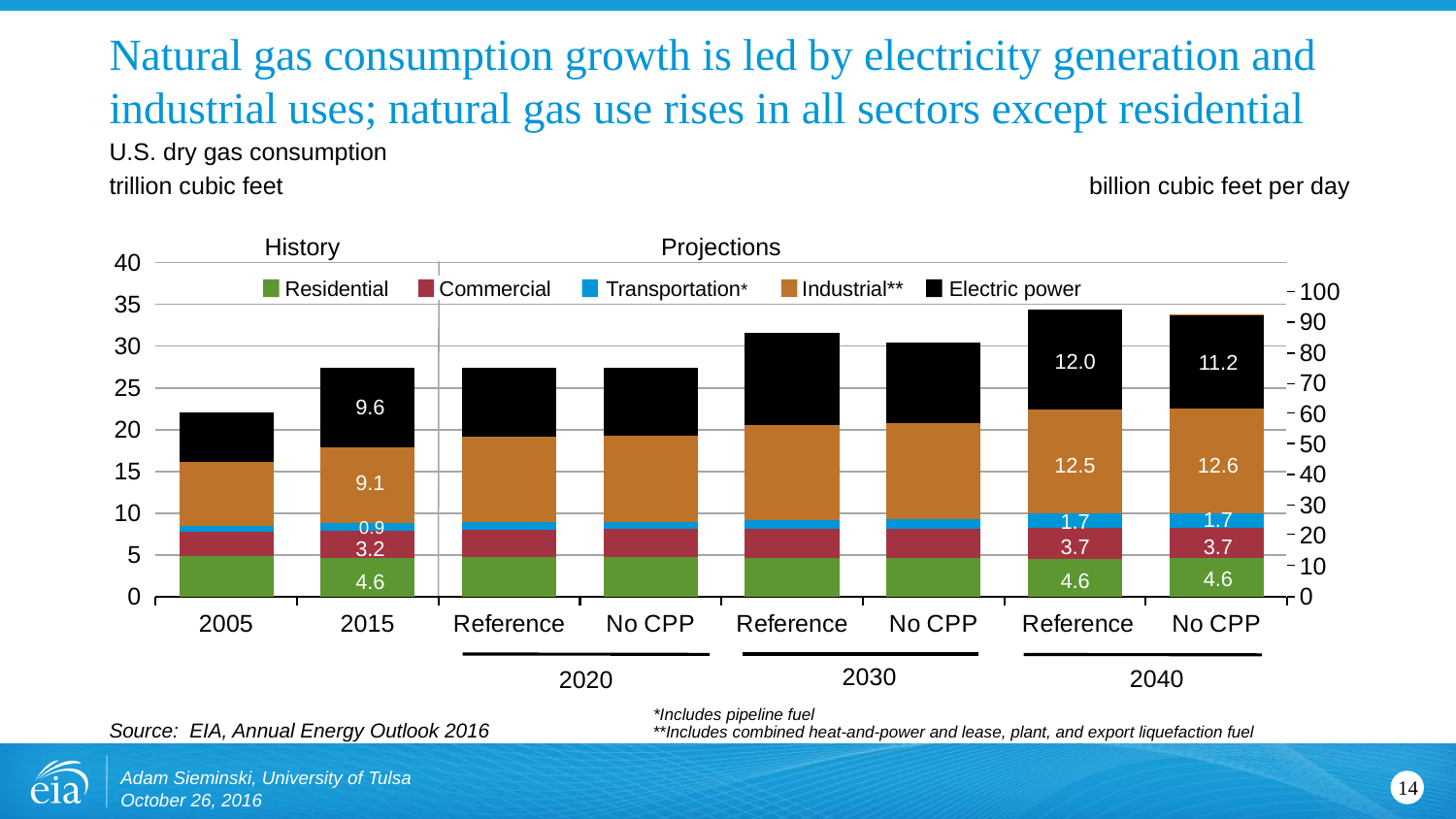
How many series does the legend list? 5 How many bars are plotted in the chart? 8 What is the difference between the Industrial value in 2040 Reference and in 2015? 3.4 Which bar has the lowest total consumption? 2005 What type of chart is shown on the slide? stacked bar chart What is the total of the 2015 stacked bar? 27.5 Which is larger, the Electric power value for 2040 Reference or for 2040 No CPP? 2040 Reference Is the total for the 2005 bar greater or less than 20 trillion cubic feet? greater What is the Electric power value for the 2015 bar? 9.6 What is the Commercial value for the 2015 bar? 3.2 What is the Transportation value for the 2040 Reference bar? 1.7 What is the Industrial value for the 2040 No CPP bar? 12.6